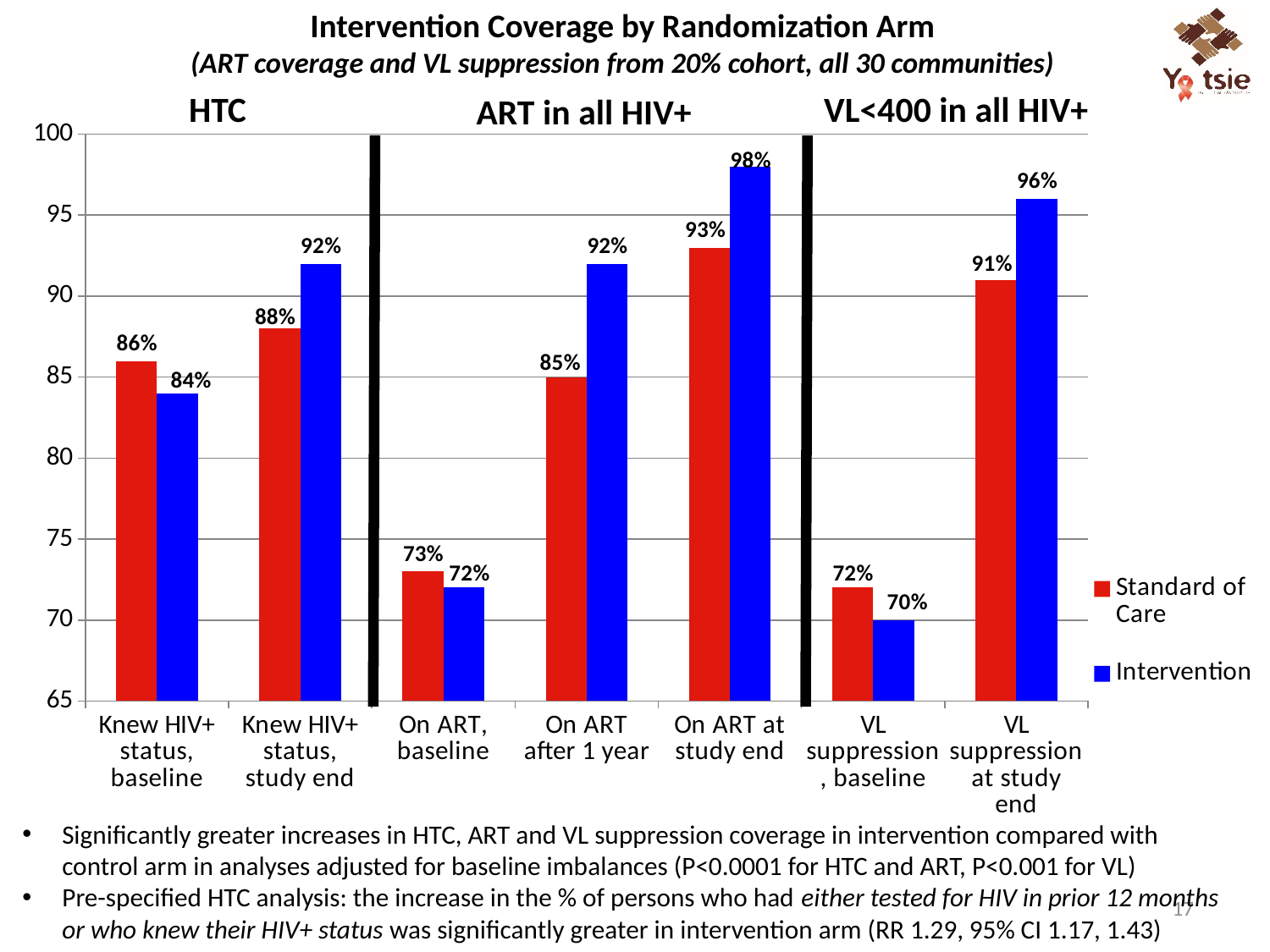
Is the Standard of Care value for 'On ART, baseline' greater or less than 75? less What is the Standard of Care value for 'Knew HIV+ status, baseline'? 86% What is the difference between the Intervention and Standard of Care values for 'On ART after 1 year'? 7% How many series does the legend list? 2 What is the Intervention value for 'On ART at study end'? 98% What is the Intervention value for 'VL suppression, baseline'? 70% Which category has the highest Intervention value? On ART at study end How many categories are shown on the x axis? 7 Which colour represents the Intervention series? blue What kind of chart is shown? bar chart For 'Knew HIV+ status, baseline', which is larger: Standard of Care or Intervention? Standard of Care Which category has the lowest Standard of Care value? VL suppression, baseline